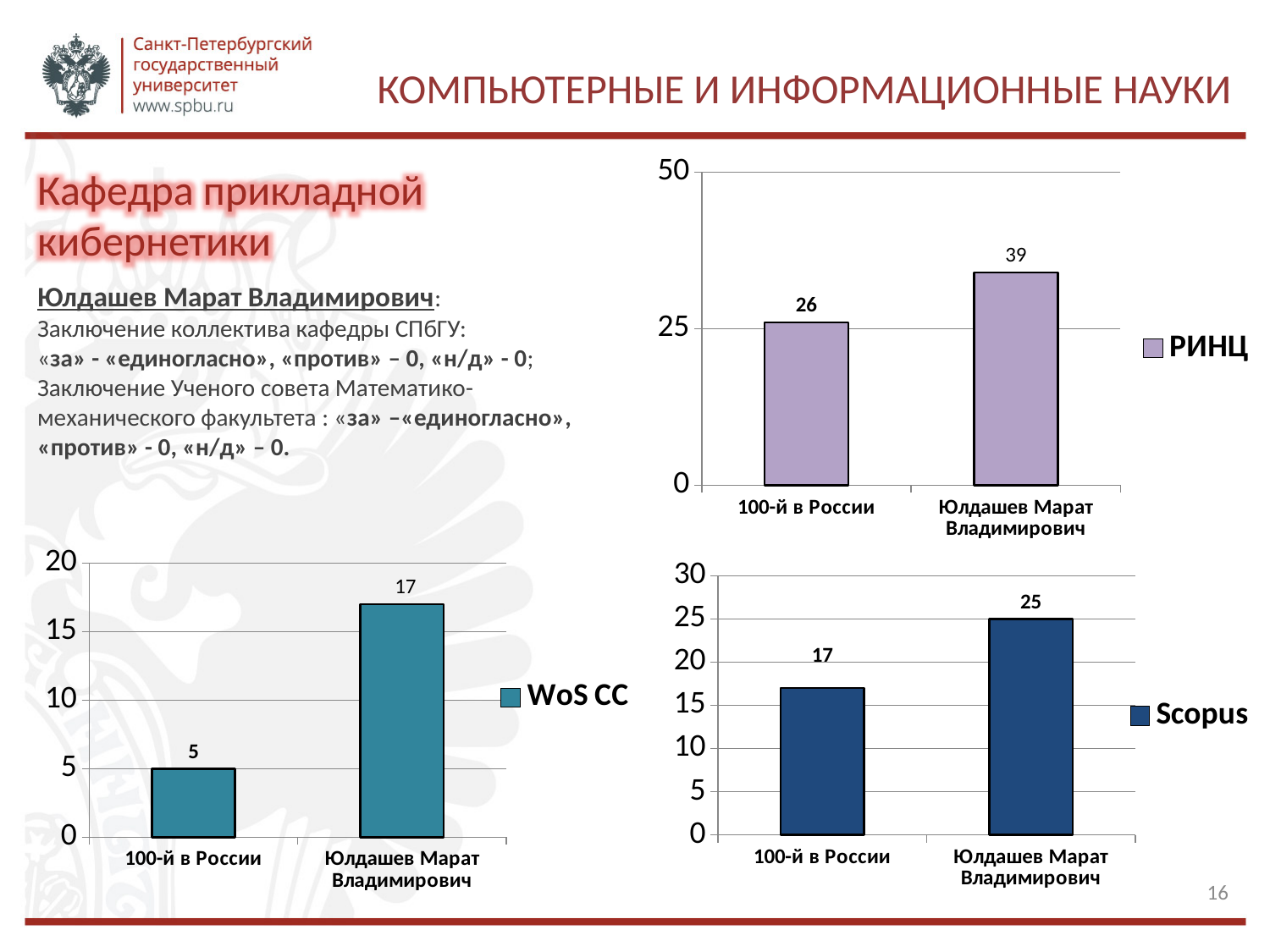
In the Scopus chart, which category has the lowest value? 100-й в России How many categories are shown in the РИНЦ chart? 2 In the РИНЦ chart, what is the value for 100-й в России? 26 In the Scopus chart, what is the value for Юлдашев Марат Владимирович? 25 In the Scopus chart, what is the value for 100-й в России? 17 In the WoS CC chart, what is the value for 100-й в России? 5 In the РИНЦ chart, what is the difference between the values for Юлдашев Марат Владимирович and 100-й в России? 13 In the WoS CC chart, what is the value for Юлдашев Марат Владимирович? 17 In the WoS CC chart, which category has the highest value? Юлдашев Марат Владимирович What kind of chart is the WoS CC chart? bar chart In the РИНЦ chart, what is the value for Юлдашев Марат Владимирович? 39 In the Scopus chart, what is the difference between the values for Юлдашев Марат Владимирович and 100-й в России? 8